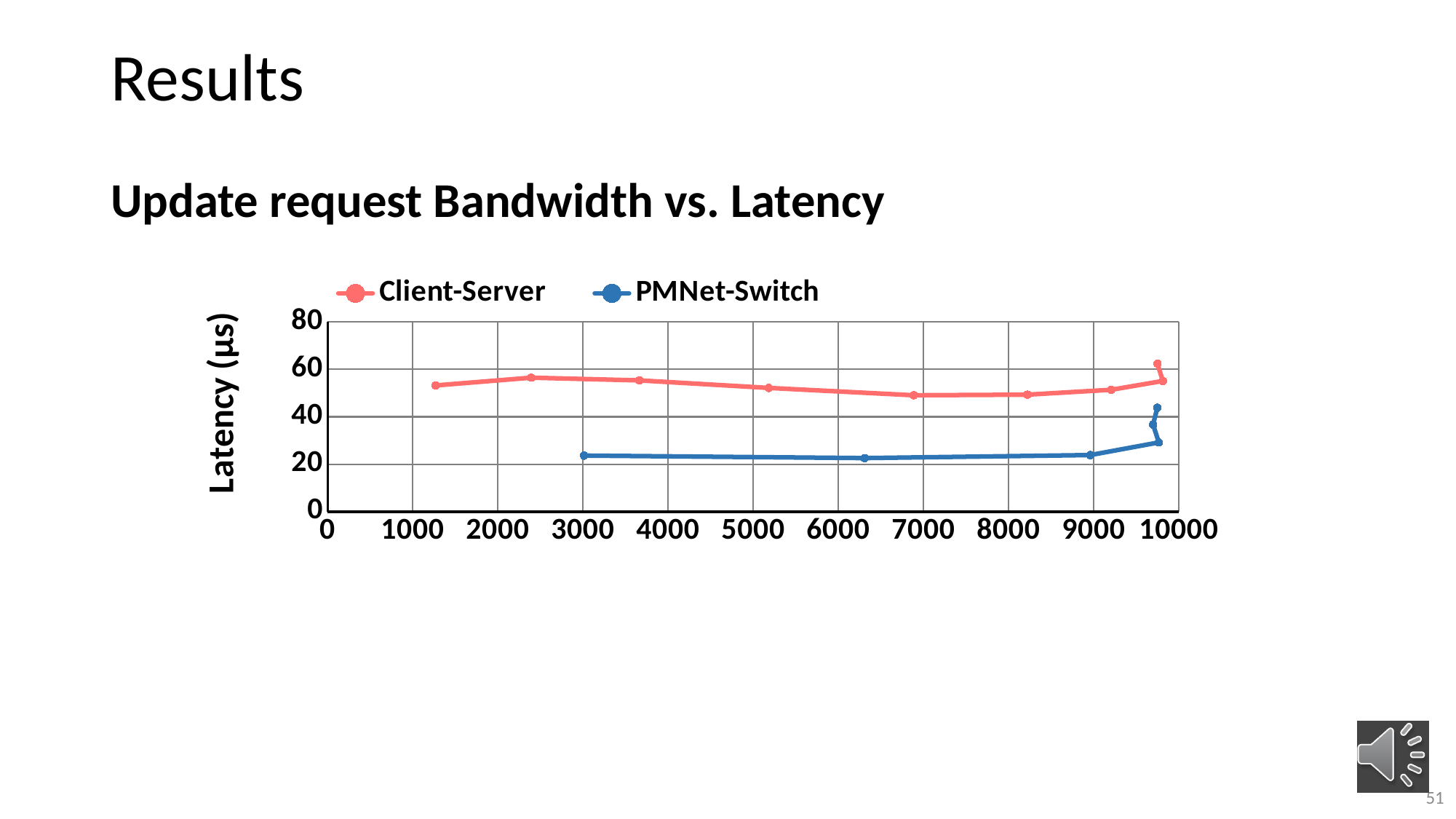
At a bandwidth of about 9000, which series has the larger latency, Client-Server or PMNet-Switch? Client-Server Is the latency for Client-Server at a bandwidth of about 6900 greater or less than 60? less Is the latency for Client-Server at a bandwidth of about 1250 greater or less than 40? greater Is the latency for PMNet-Switch at a bandwidth of about 6300 greater or less than 20? greater How many series does the legend list? 2 What is the maximum value shown on the y axis? 80 Which series has the higher latency across the plotted bandwidth range, Client-Server or PMNet-Switch? Client-Server What is the label of the y axis? Latency (µs) What kind of chart is shown on the slide? line chart Which series has the lowest latency values on the chart? PMNet-Switch What are the two series named in the legend? Client-Server and PMNet-Switch